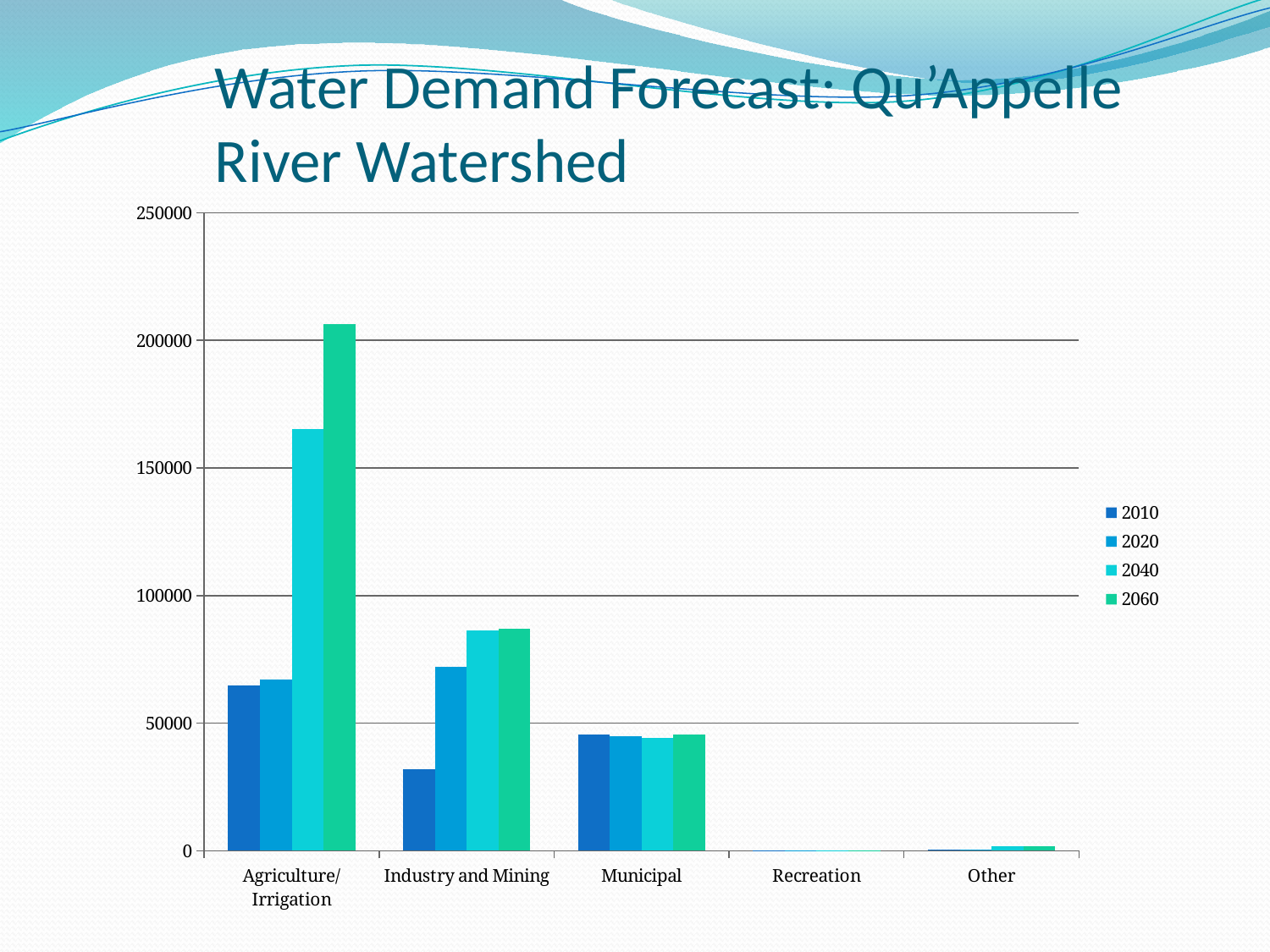
What is the title of the slide containing the chart? Water Demand Forecast: Qu'Appelle River Watershed Do the values for Agriculture/Irrigation rise or fall from the 2010 series to the 2060 series? rise Which is larger, the 2040 value for Agriculture/Irrigation or the 2040 value for Industry and Mining? Agriculture/Irrigation Is the 2040 value for Agriculture/Irrigation greater or less than 150000? greater Which category has the highest value for the 2060 series? Agriculture/Irrigation Is the 2010 value for Municipal greater or less than 50000? less How many series does the legend list? 4 Is the 2010 value for Industry and Mining greater or less than 50000? less Which category has the lowest value for the 2060 series? Recreation What kind of chart is shown on the slide? bar chart How many categories are shown on the x axis of the chart? 5